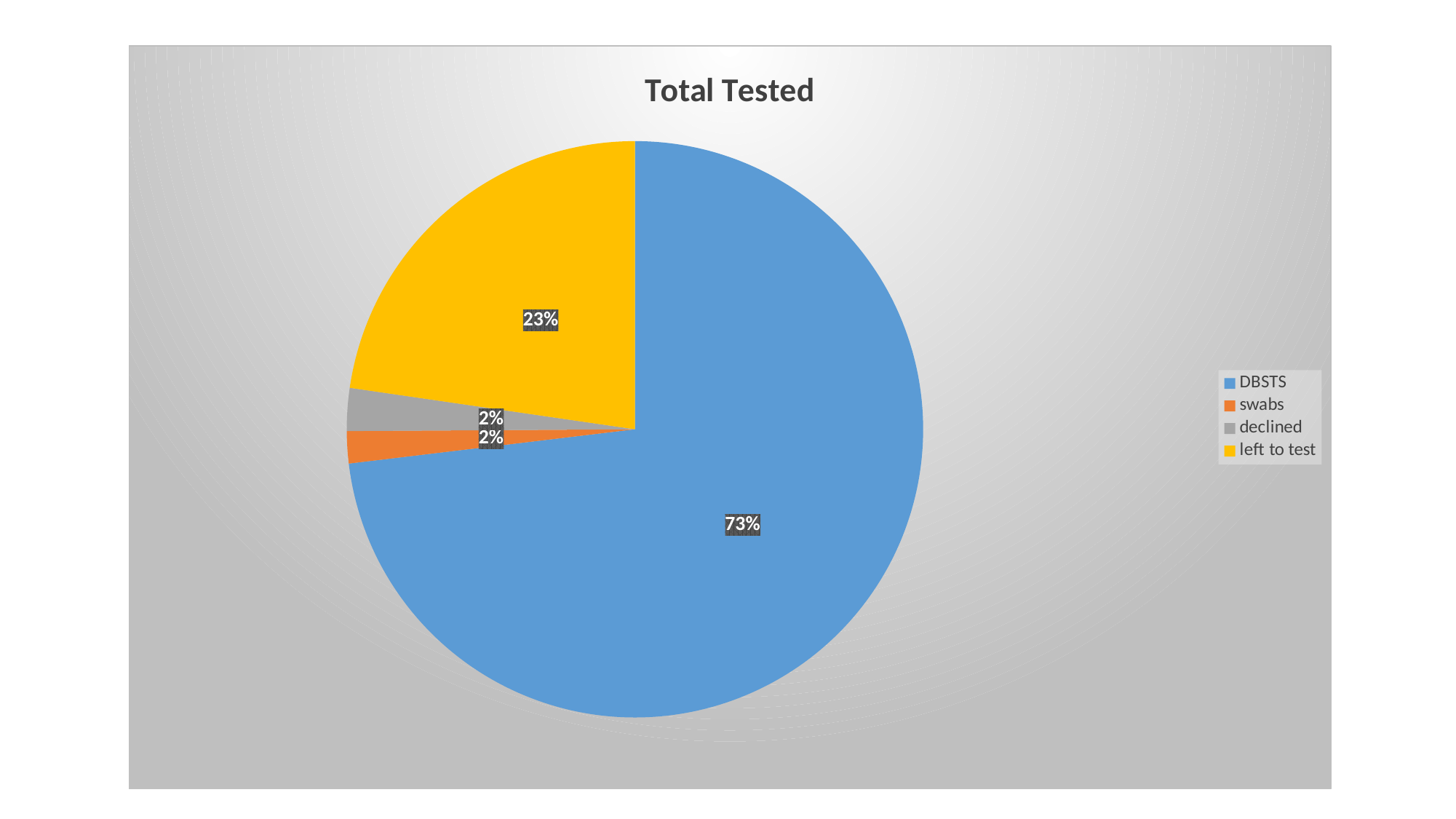
What share of the pie does declined represent? 2% Which category has the largest slice of the pie? DBSTS What colour is the slice for left to test? yellow What type of chart is shown on the slide? pie chart What share of the pie does DBSTS represent? 73% What share of the pie does swabs represent? 2% What is the title of the chart? Total Tested Which is larger, the share for DBSTS or the share for left to test? DBSTS How many categories does the legend list? 4 What is the difference in percentage points between the DBSTS share and the left to test share? 50 What is the combined share of DBSTS and left to test? 96%